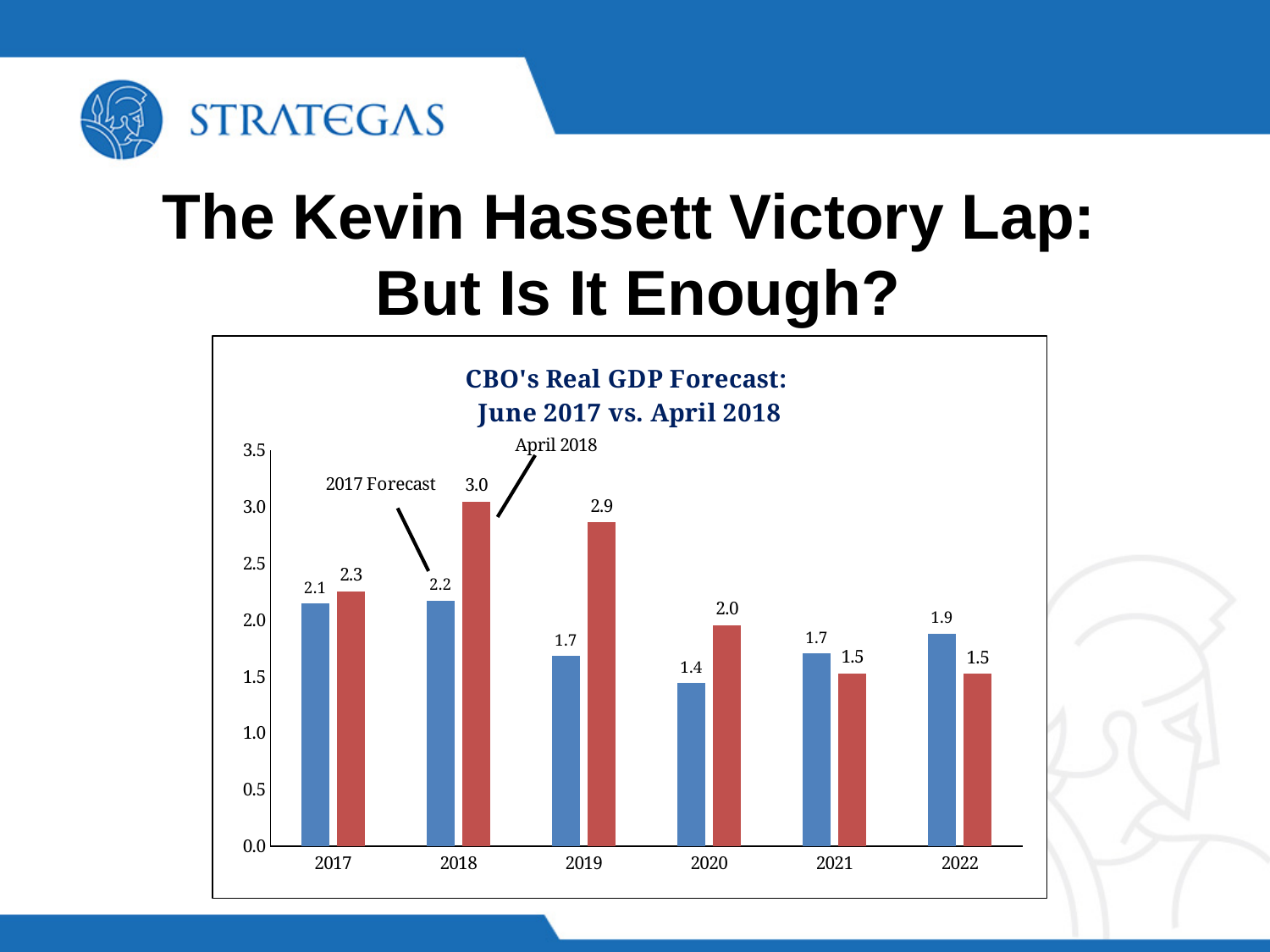
What is the April 2018 forecast value for 2018? 3.0 What is the difference between the April 2018 and 2017 Forecast values for 2019? 1.2 How many years are shown on the x axis? 6 What is the 2017 Forecast value for 2022? 1.9 What is the title of the chart? CBO's Real GDP Forecast: June 2017 vs. April 2018 What is the 2017 Forecast value for 2020? 1.4 Which year has the highest April 2018 forecast value? 2018 What kind of chart is shown on the slide? Bar chart What is the April 2018 forecast value for 2019? 2.9 How many data series does the chart plot? 2 Which year has the lowest 2017 Forecast value? 2020 For 2021, which is larger: the 2017 Forecast or the April 2018 forecast? 2017 Forecast